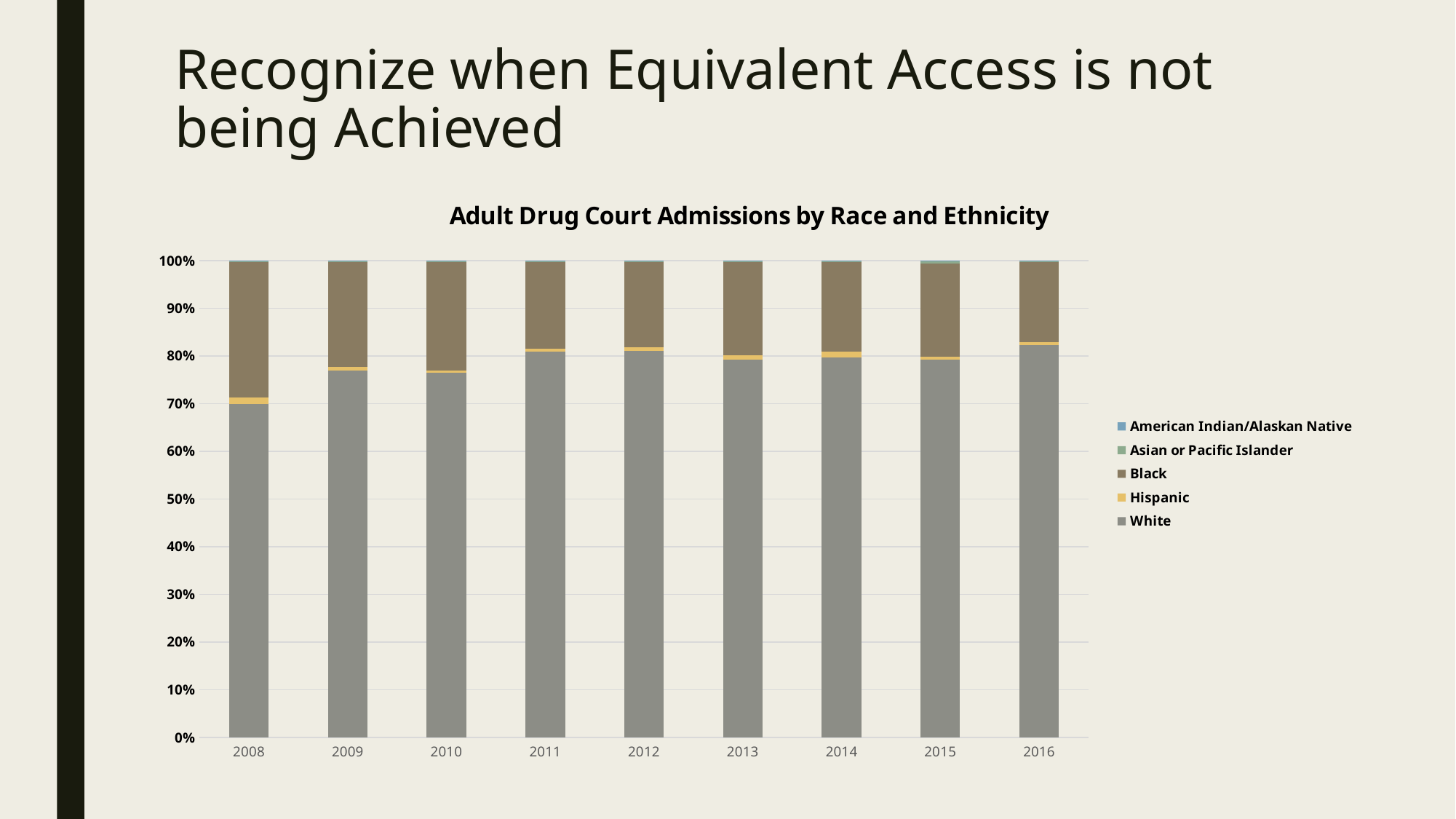
Is the White share of admissions in 2008 greater or less than 80%? less Which colour represents the Hispanic series in the legend? Yellow Is the White share of admissions in 2010 greater or less than 80%? less Which year has a larger White share of admissions, 2008 or 2016? 2016 Is the White share of admissions in 2016 greater or less than 80%? greater Which year has the largest Black share of adult drug court admissions? 2008 Which year has the smallest White share of adult drug court admissions? 2008 How many years are shown along the x axis of the chart? 9 How many series does the chart's legend list? 5 What is the title of the chart? Adult Drug Court Admissions by Race and Ethnicity What kind of chart is shown on the slide? Stacked bar chart Which year has a larger Black share of admissions, 2008 or 2016? 2008